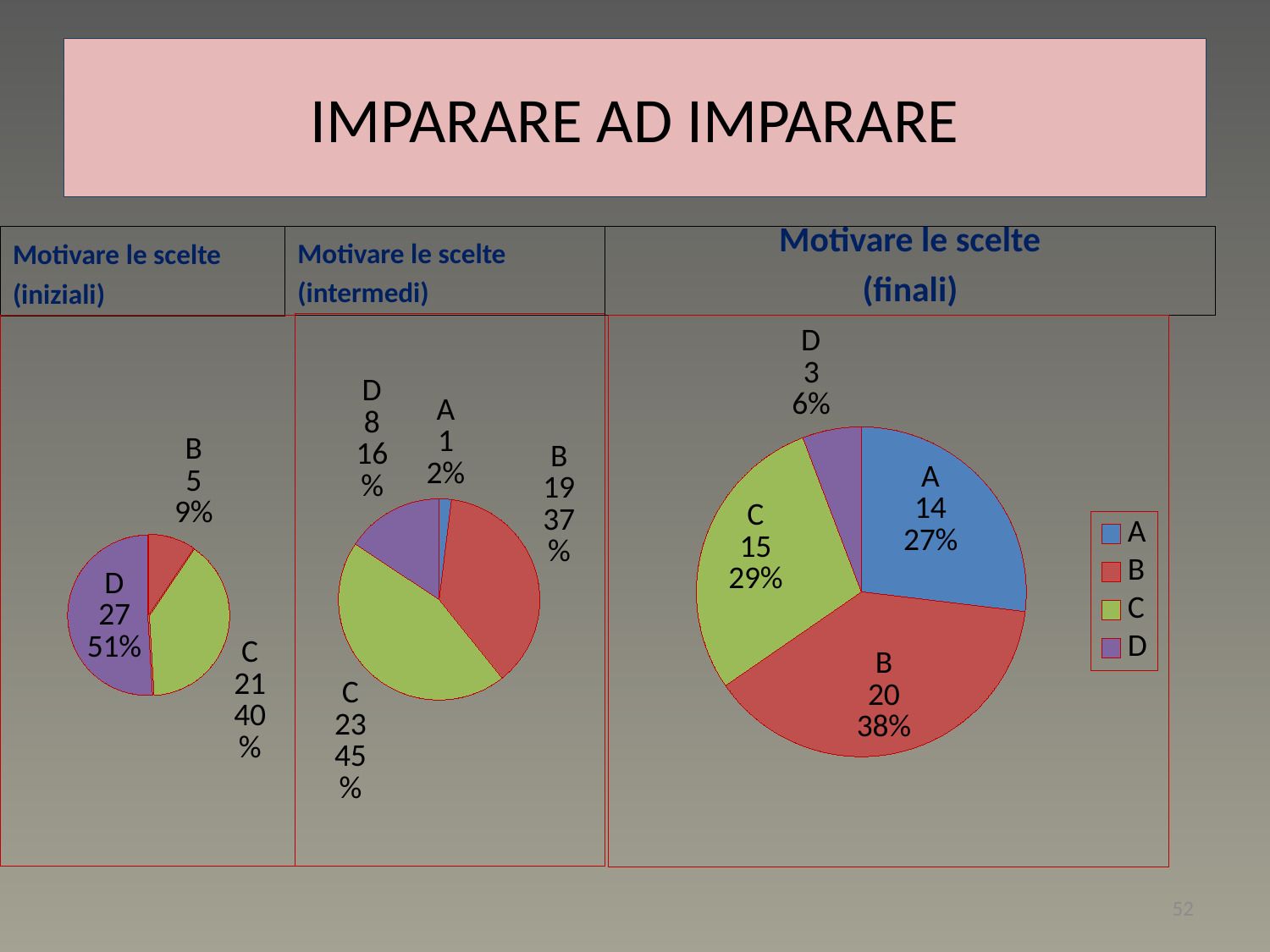
In the 'Motivare le scelte (finali)' chart, what is the value for category B? 20 In the 'Motivare le scelte (finali)' chart, what percentage share does category A have? 27% What kind of chart is used in the 'Motivare le scelte (finali)' panel? Pie chart In the 'Motivare le scelte (iniziali)' chart, which is larger, the value for C or the value for B? C In the 'Motivare le scelte (iniziali)' chart, what is the value for category D? 27 How many entries does the legend of the 'Motivare le scelte (finali)' chart list? 4 In the 'Motivare le scelte (finali)' chart, what colour is the slice for category C? Green In the 'Motivare le scelte (intermedi)' chart, what percentage share does category D have? 16% In the 'Motivare le scelte (intermedi)' chart, what is the value for category C? 23 In the 'Motivare le scelte (finali)' chart, what is the difference between the values for B and D? 17 In the 'Motivare le scelte (intermedi)' chart, which category has the smallest slice? A In the 'Motivare le scelte (iniziali)' chart, which category has the largest slice? D